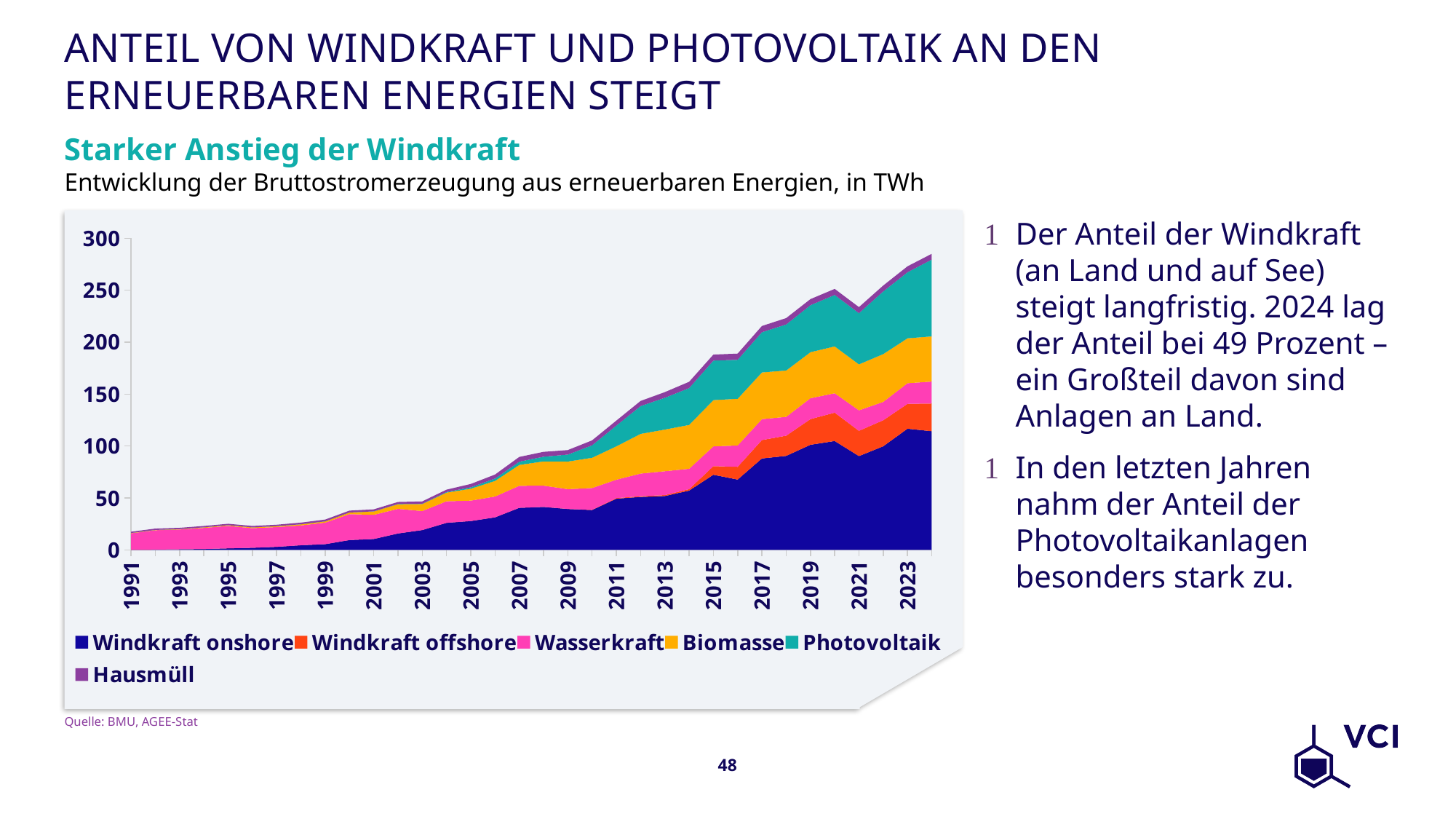
Is the Windkraft onshore value in 2023 greater or less than 100 TWh? greater Which series are listed in the chart's legend? Windkraft onshore, Windkraft offshore, Wasserkraft, Biomasse, Photovoltaik, Hausmüll What kind of chart is shown on the slide? Stacked area chart Does the total gross electricity generation from renewables rise or fall from 1991 to the end of the series? Rise Is the total renewable generation in 1991 greater or less than 50 TWh? less In 2023, which is larger: Windkraft onshore or Photovoltaik? Windkraft onshore Which series contributes the largest share of the total at the right end of the chart? Windkraft onshore How many series does the chart's legend list? 6 Is the total renewable generation in 2007 greater or less than 50 TWh? greater What unit is the gross electricity generation shown in, according to the chart subtitle? TWh